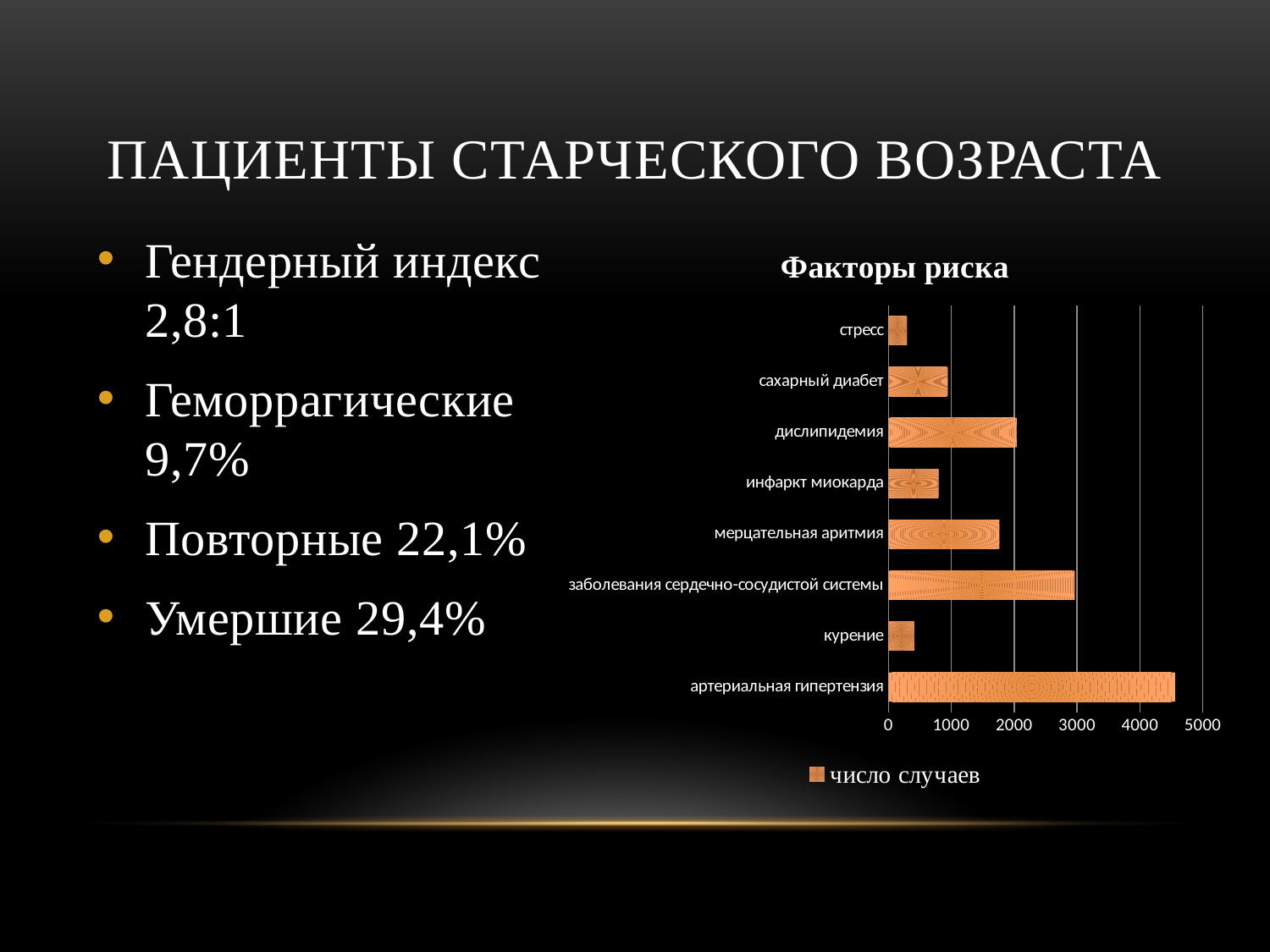
What is the title of the chart? Факторы риска What is the name of the series shown in the legend? число случаев Is the value for мерцательная аритмия greater or less than 1000? greater How many categories are plotted in the chart? 8 Which has more cases, дислипидемия or мерцательная аритмия? дислипидемия What kind of chart is shown on the slide? bar chart Is the value for стресс greater or less than 1000? less Which has more cases, заболевания сердечно-сосудистой системы or дислипидемия? заболевания сердечно-сосудистой системы Is the value for заболевания сердечно-сосудистой системы greater or less than 2000? greater Which risk factor has the highest number of cases? артериальная гипертензия How many series does the chart legend list? 1